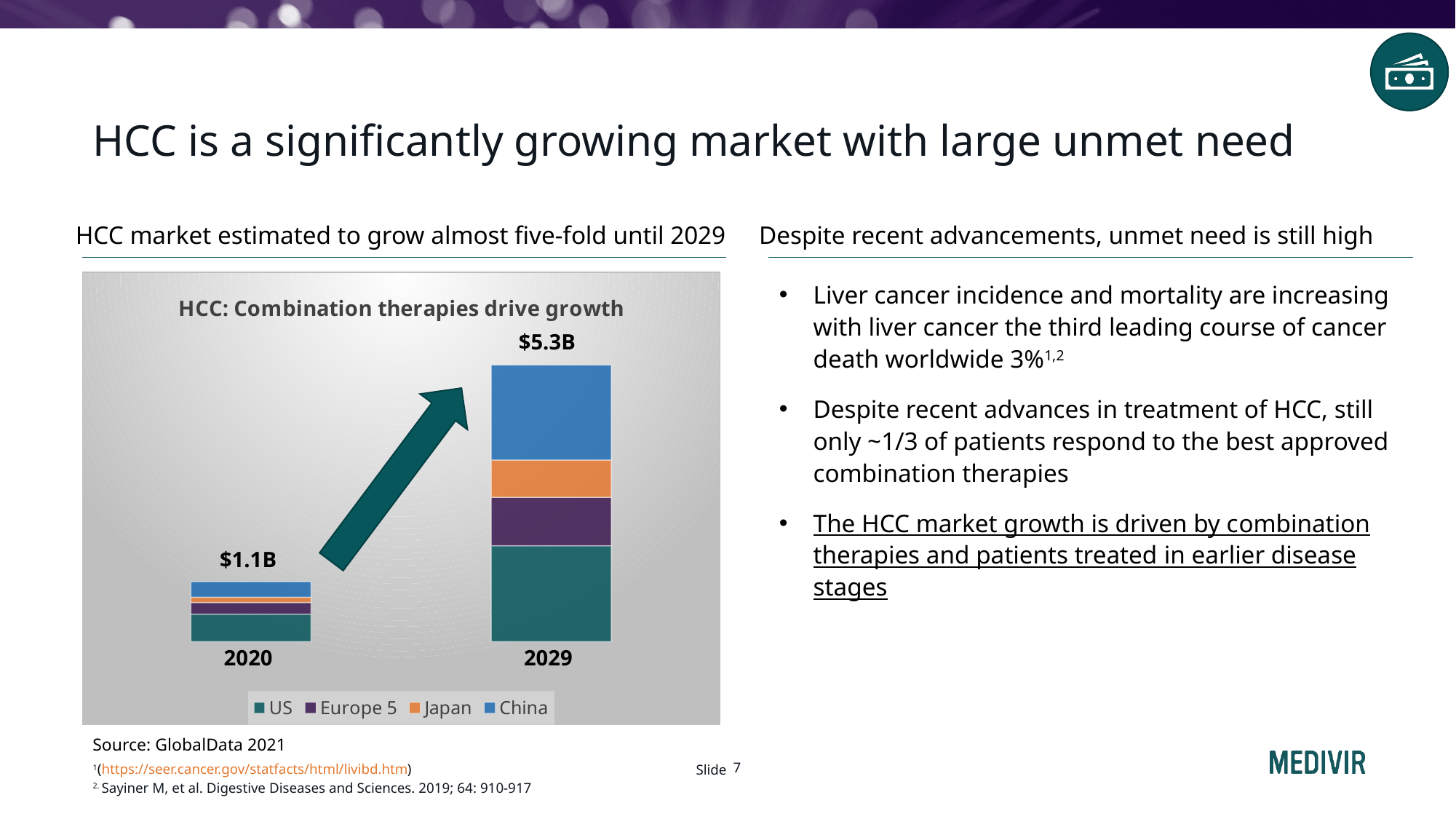
Which year has the lower total market value? 2020 In the 2029 bar, which segment is larger: US or Japan? US What is the total HCC market value shown for 2029? $5.3B Does the total market value rise or fall from 2020 to 2029? Rise Which year has the higher total market value? 2029 What kind of chart is shown on the slide? Stacked bar chart Is the total for 2029 larger or smaller than the total for 2020? Larger What is the title of the chart? HCC: Combination therapies drive growth How many years (categories) are plotted in the chart? 2 What is the difference between the 2029 total and the 2020 total? $4.2B How many series does the chart legend list? 4 What is the total HCC market value shown for 2020? $1.1B